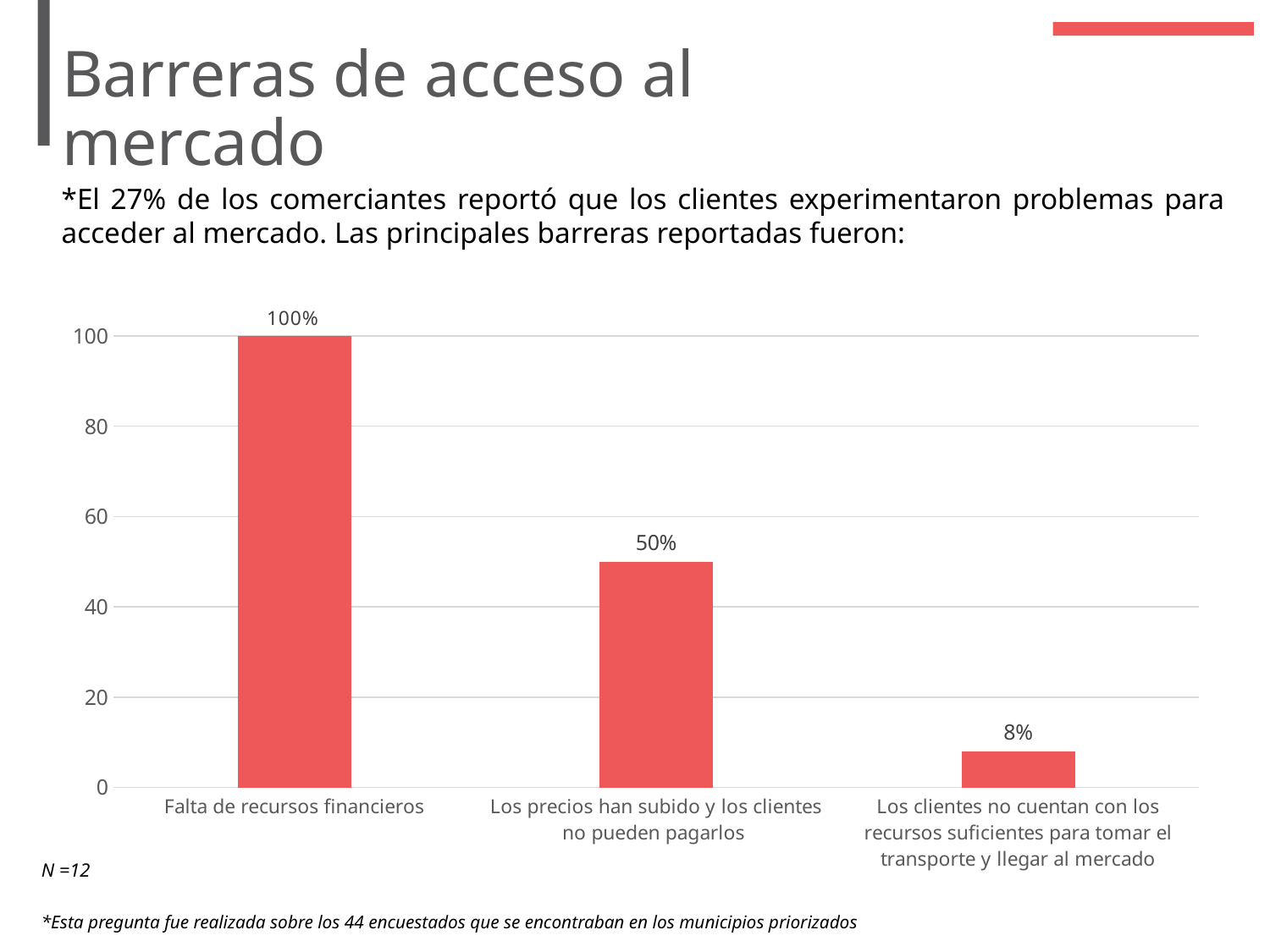
What is the difference between the values for "Los precios han subido y los clientes no pueden pagarlos" and "Los clientes no cuentan con los recursos suficientes para tomar el transporte y llegar al mercado"? 42% How many categories are shown in the chart? 3 Which category has the lowest value? Los clientes no cuentan con los recursos suficientes para tomar el transporte y llegar al mercado Is the value for "Los precios han subido y los clientes no pueden pagarlos" greater or less than 40? greater What kind of chart is shown on the slide? bar chart What is the value for "Los precios han subido y los clientes no pueden pagarlos"? 50% Which category has the highest value? Falta de recursos financieros What is the value for "Falta de recursos financieros"? 100% Which is larger: the value for "Los precios han subido y los clientes no pueden pagarlos" or the value for "Los clientes no cuentan con los recursos suficientes para tomar el transporte y llegar al mercado"? Los precios han subido y los clientes no pueden pagarlos What is the difference between the values for "Falta de recursos financieros" and "Los precios han subido y los clientes no pueden pagarlos"? 50% What is the value for "Los clientes no cuentan con los recursos suficientes para tomar el transporte y llegar al mercado"? 8% Do the values rise or fall from left to right across the categories? fall